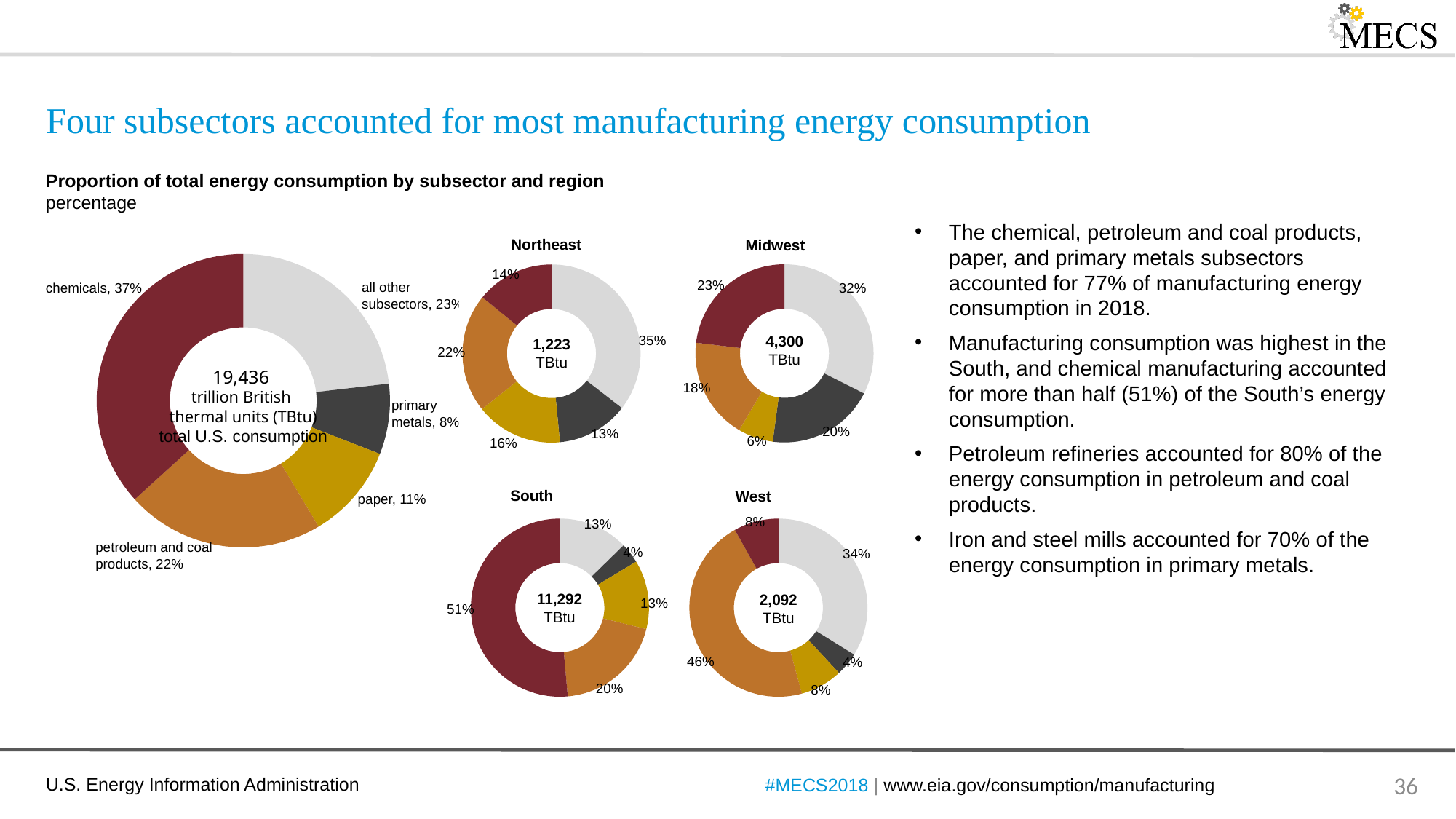
What type of chart is used to show the proportion of total energy consumption by subsector and region? donut (pie) chart In the West donut chart, what is the largest slice's percentage? 46% In the large U.S. total donut chart, how many slices are shown? 5 In the large U.S. total donut chart, what share of energy consumption is attributed to chemicals? 37% In the large U.S. total donut chart, what is the total U.S. consumption shown in the center? 19,436 trillion British thermal units (TBtu) In the large U.S. total donut chart, which subsector has the smallest share? primary metals In the South donut chart, what is the largest slice's percentage? 51% In the Midwest donut chart, what total consumption is shown in the center? 4,300 TBtu In the large U.S. total donut chart, how many percentage points larger is the chemicals share than the petroleum and coal products share? 15 percentage points In the South donut chart, what total consumption is shown in the center? 11,292 TBtu Comparing the center totals of the four regional donut charts, which region has the highest total consumption? South In the large U.S. total donut chart, which subsector has the largest share? chemicals